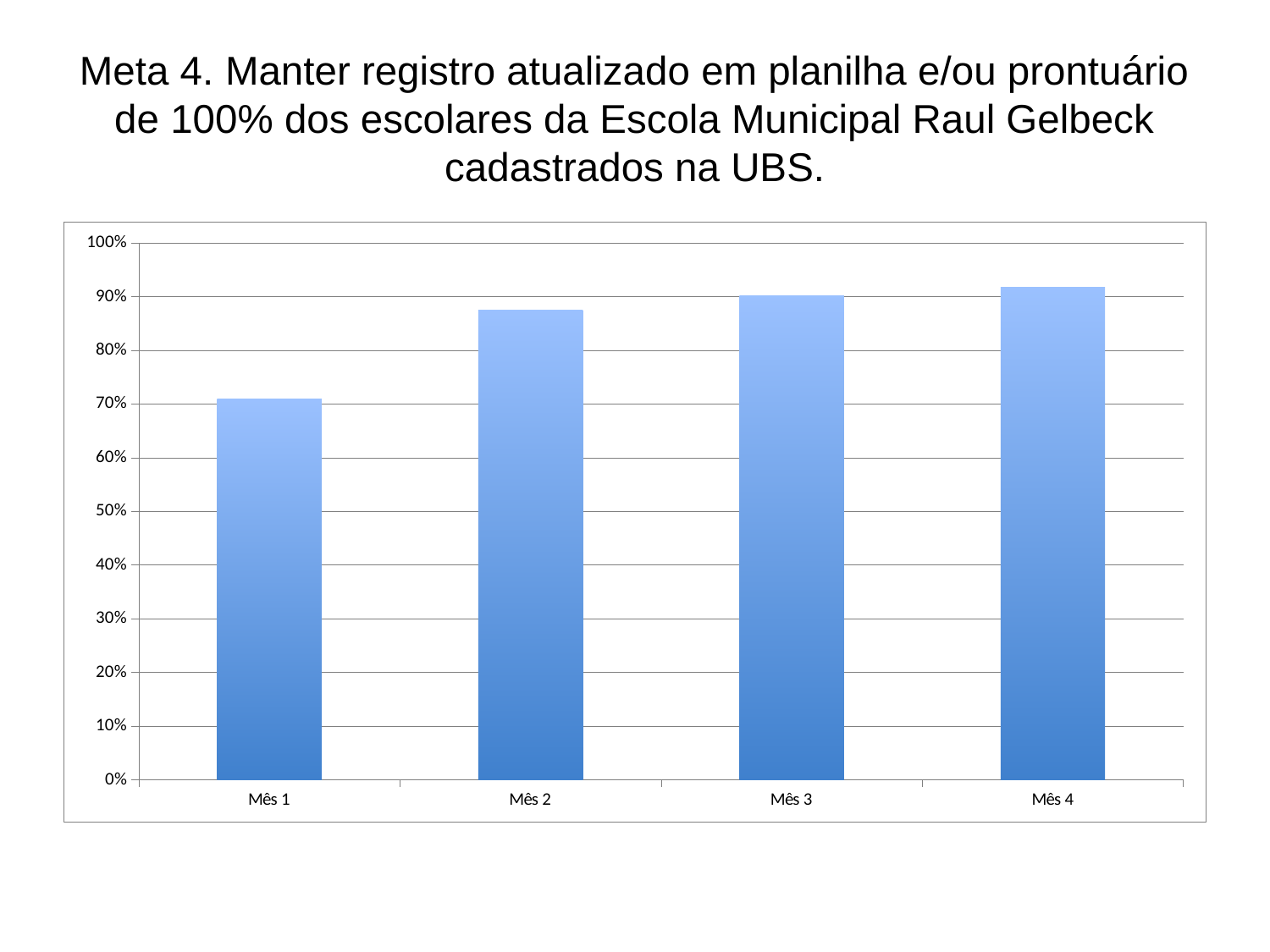
Is the value for Mês 1 greater or less than 80%? less Do the values rise or fall from Mês 1 to Mês 4? rise Which month has the lowest value in the chart? Mês 1 Which month has the highest value in the chart? Mês 4 Is the value for Mês 3 greater or less than 80%? greater Which is larger, the value for Mês 1 or the value for Mês 2? Mês 2 How many categories (months) are shown on the x axis of the chart? 4 Is the value for Mês 4 greater or less than 100%? less What kind of chart is shown on the slide? bar chart What is the highest tick value shown on the y axis of the chart? 100%